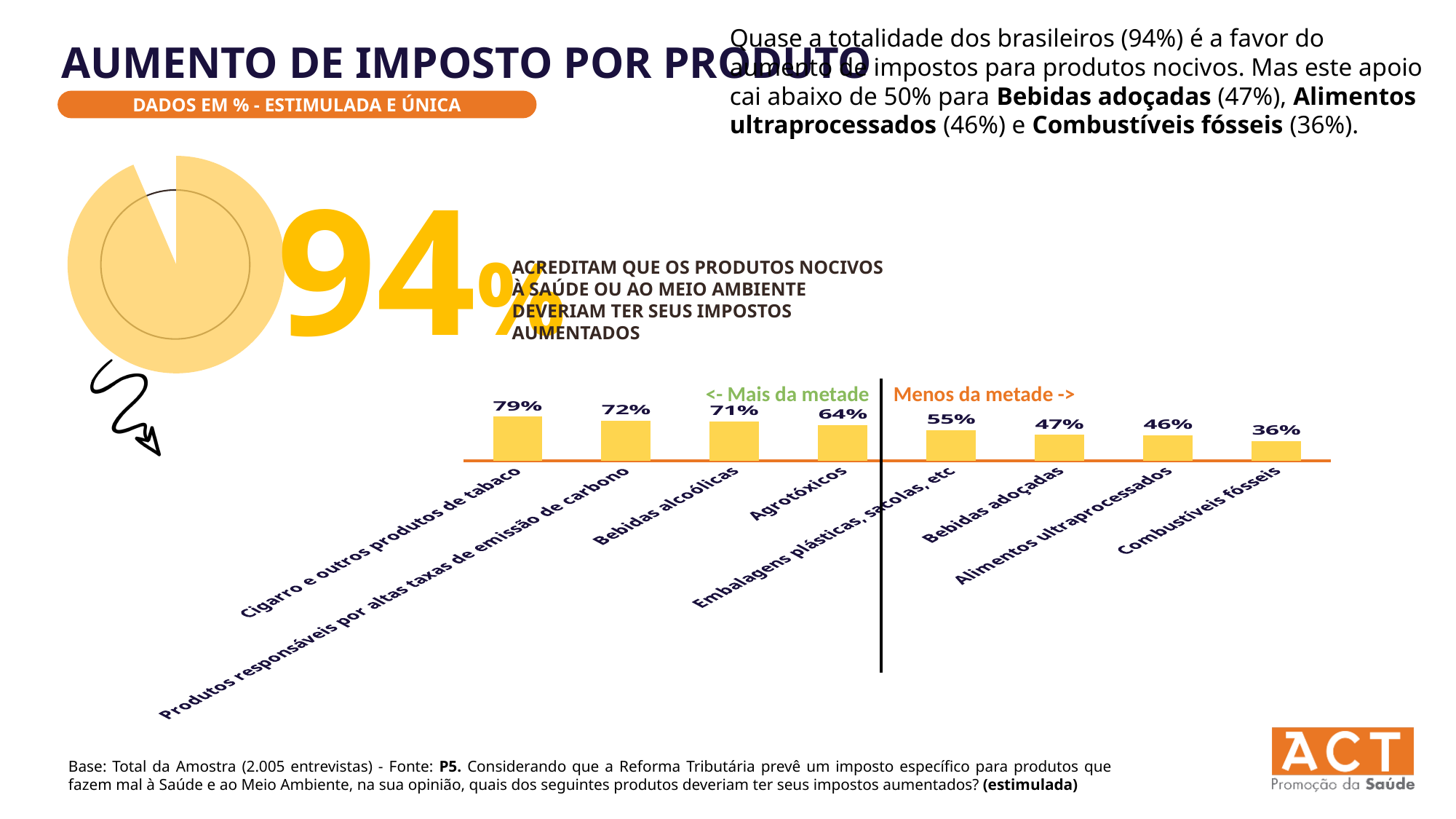
What percentage does the pie chart on the left of the slide highlight? 94% In the bar chart, which is larger: the value for Bebidas alcoólicas or the value for Agrotóxicos? Bebidas alcoólicas In the bar chart, what is the value for Agrotóxicos? 64% How many categories does the bar chart show? 8 In the bar chart, what is the difference between the values for Cigarro e outros produtos de tabaco and Combustíveis fósseis? 43% In the bar chart, which category has the highest value? Cigarro e outros produtos de tabaco In the bar chart, do the values rise or fall from left to right? Fall In the bar chart, which category has the lowest value? Combustíveis fósseis In the bar chart, what is the value for Cigarro e outros produtos de tabaco? 79% In the bar chart, what is the difference between the values for Bebidas adoçadas and Alimentos ultraprocessados? 1% What kind of chart is the chart at the bottom of the slide? Bar chart In the bar chart, what is the value for Embalagens plásticas, sacolas, etc? 55%